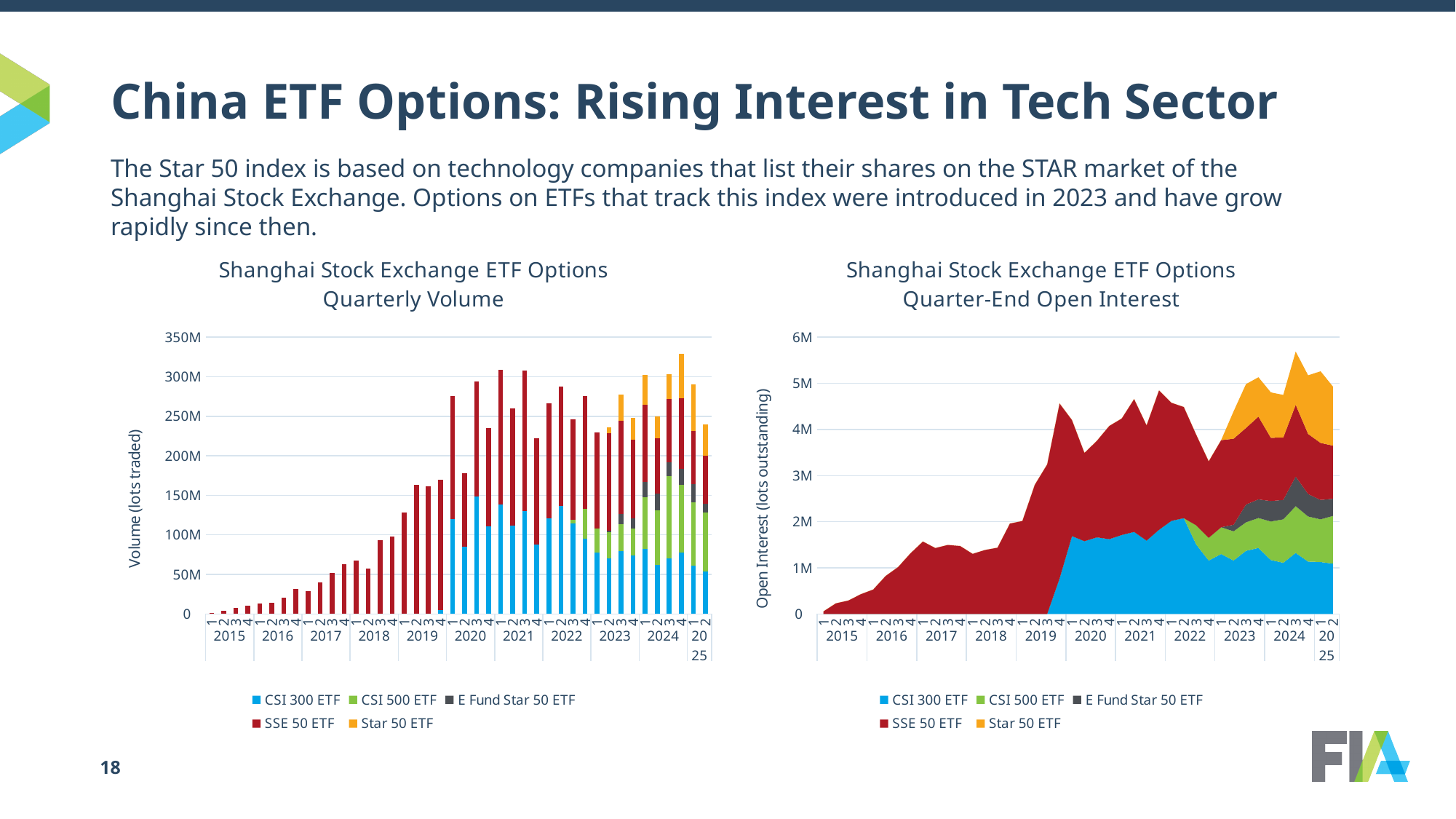
What is the y-axis label of the Quarter-End Open Interest chart? Open Interest (lots outstanding) In the Quarterly Volume chart, which quarter has the highest total volume? Q4 2024 What kind of chart is the 'Shanghai Stock Exchange ETF Options Quarter-End Open Interest' chart on the right? Stacked area chart What kind of chart is the 'Shanghai Stock Exchange ETF Options Quarterly Volume' chart on the left? Stacked bar chart How many series does the legend of the Quarter-End Open Interest chart list? 5 In the Quarterly Volume chart, does total volume generally rise or fall from 2015 to 2020? Rise In the Quarter-End Open Interest chart, is the total open interest at Q1 2015 greater or less than 1M? less In the Quarterly Volume chart, which is larger: the total volume for Q1 2020 or for Q1 2019? Q1 2020 How many series does the legend of the Quarterly Volume chart list? 5 In the Quarterly Volume chart, is the total volume for Q4 2024 greater or less than 300M? greater In the Quarter-End Open Interest chart, is the total open interest at Q3 2024 greater or less than 5M? greater